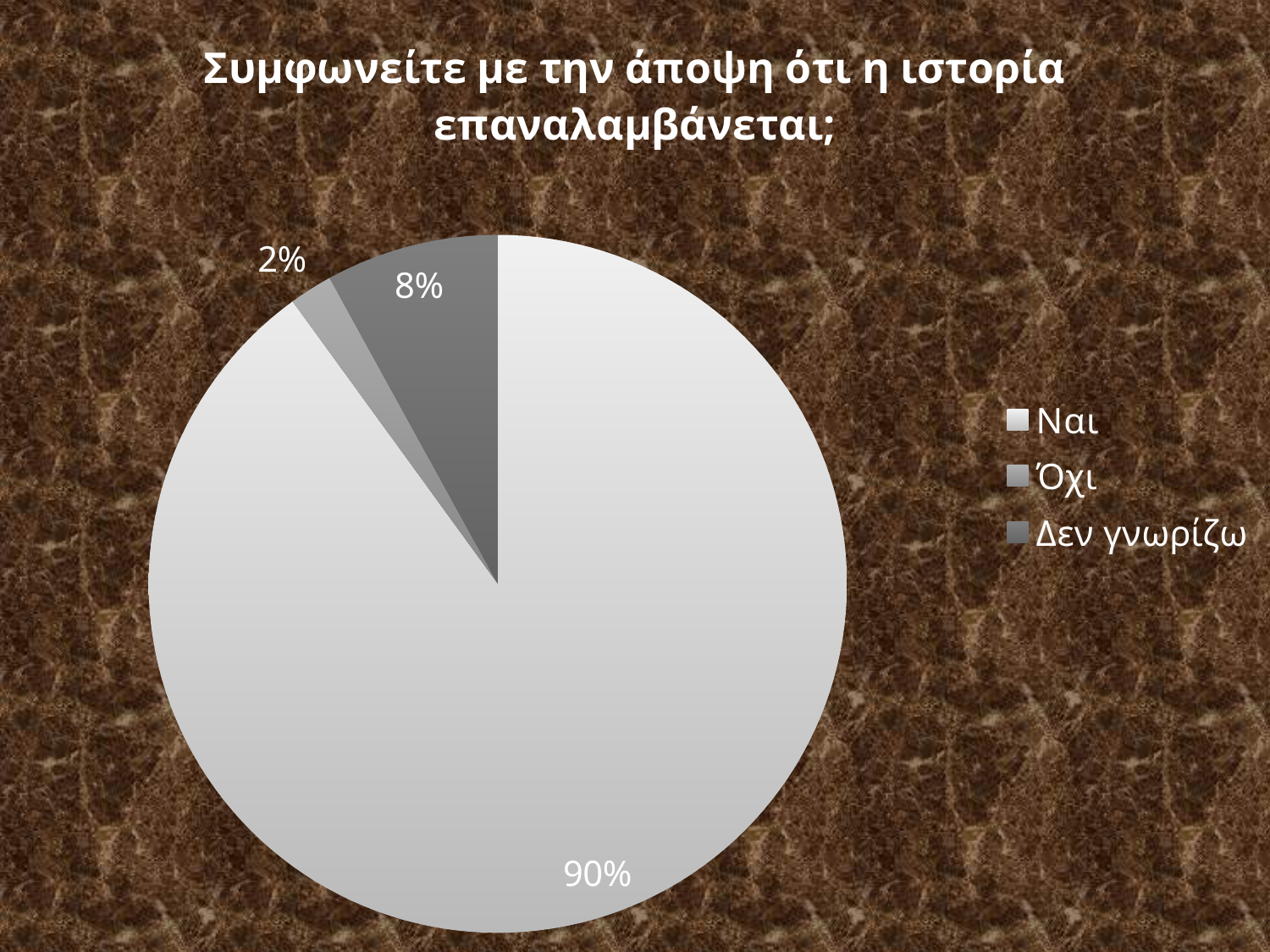
What is the title of the chart? Συμφωνείτε με την άποψη ότι η ιστορία επαναλαμβάνεται; How many slices does the pie chart have? 3 What share of the pie does Δεν γνωρίζω represent? 8% Which category has the smallest slice? Όχι What is the difference in percentage points between the Ναι slice and the Δεν γνωρίζω slice? 82% What kind of chart is shown on the slide? pie chart What share of the pie does Όχι represent? 2% How many categories does the legend list? 3 Which category has the largest slice? Ναι What share of the pie does Ναι represent? 90% Which is larger, the slice for Όχι or the slice for Δεν γνωρίζω? Δεν γνωρίζω What is the difference in percentage points between the Δεν γνωρίζω slice and the Όχι slice? 6%